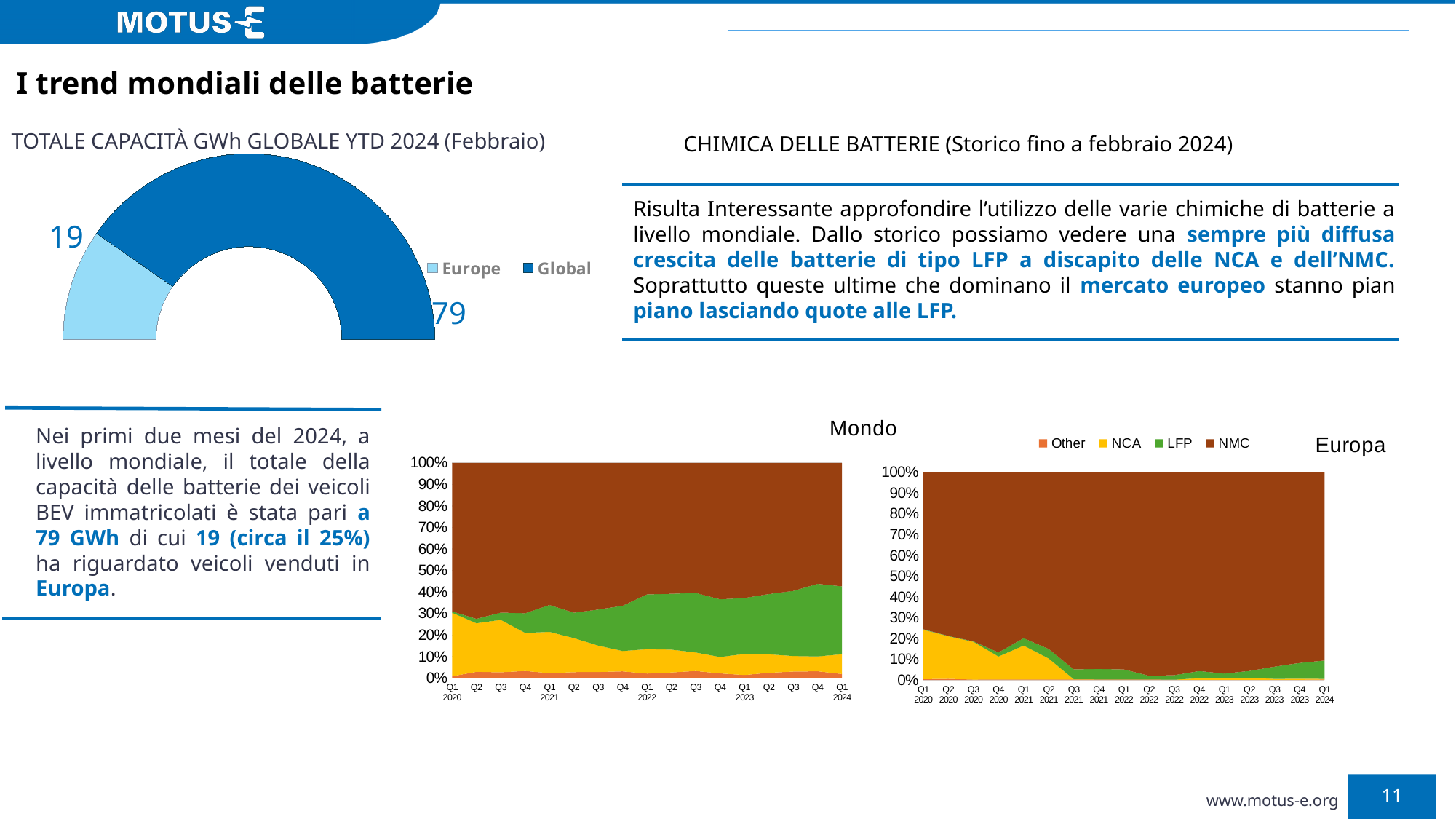
What kind of chart is the 'Mondo' chart? Stacked area chart In the 'Europa' chart, is the share of NMC in Q1 2024 greater or less than 80%? greater In the half-doughnut chart 'TOTALE CAPACITÀ GWh GLOBALE YTD 2024 (Febbraio)', which is larger, Europe or Global? Global In the 'Europa' chart, does the share of NCA rise or fall from Q1 2020 to Q1 2024? Fall How many entries does the legend of the half-doughnut chart 'TOTALE CAPACITÀ GWh GLOBALE YTD 2024 (Febbraio)' list? 2 In the half-doughnut chart 'TOTALE CAPACITÀ GWh GLOBALE YTD 2024 (Febbraio)', what is the value for Europe? 19 In the half-doughnut chart 'TOTALE CAPACITÀ GWh GLOBALE YTD 2024 (Febbraio)', what is the difference between the Global and Europe values? 60 How many quarters are shown on the x axis of the 'Mondo' chart? 17 In the half-doughnut chart 'TOTALE CAPACITÀ GWh GLOBALE YTD 2024 (Febbraio)', what is the value for Global? 79 In the 'Mondo' chart, does the share of LFP rise or fall from Q1 2020 to Q1 2024? Rise How many series does the legend shared by the 'Mondo' and 'Europa' charts list? 4 What kind of chart is the 'TOTALE CAPACITÀ GWh GLOBALE YTD 2024 (Febbraio)' chart? Doughnut chart